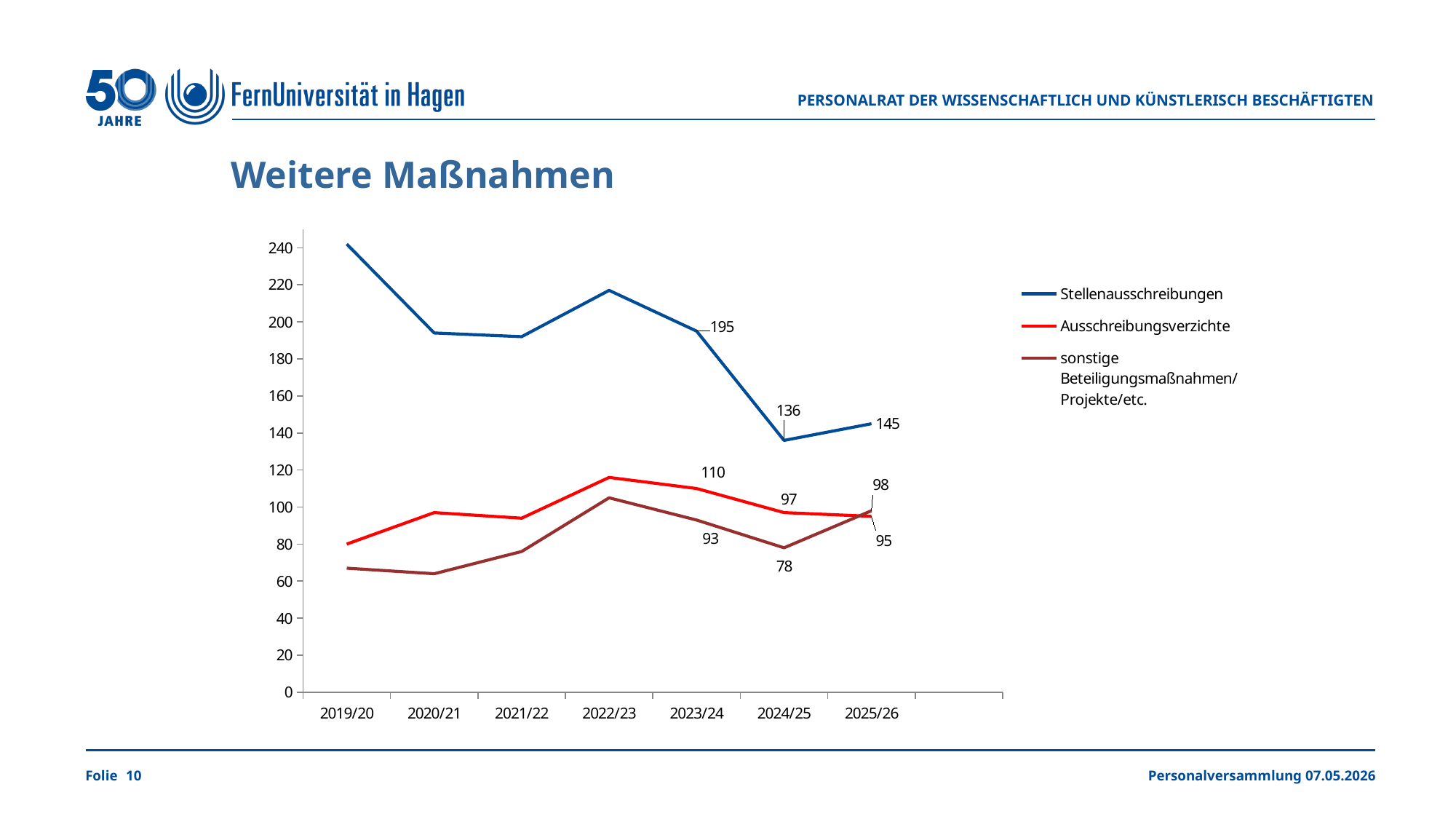
What is the value for Ausschreibungsverzichte in 2023/24? 110 What is the value for Stellenausschreibungen in 2025/26? 145 In which year is the value for Stellenausschreibungen highest? 2019/20 By how much did Stellenausschreibungen fall from 2023/24 to 2024/25? 59 How many academic years are shown on the x axis? 7 What kind of chart is shown on the slide? line chart Is the value for sonstige Beteiligungsmaßnahmen/Projekte/etc. in 2020/21 greater or less than 80? less In 2025/26, which is larger: Ausschreibungsverzichte or sonstige Beteiligungsmaßnahmen/Projekte/etc.? sonstige Beteiligungsmaßnahmen/Projekte/etc. How many series does the legend list? 3 Is the value for Stellenausschreibungen in 2019/20 greater or less than 220? greater What is the value for sonstige Beteiligungsmaßnahmen/Projekte/etc. in 2024/25? 78 What is the value for Stellenausschreibungen in 2024/25? 136